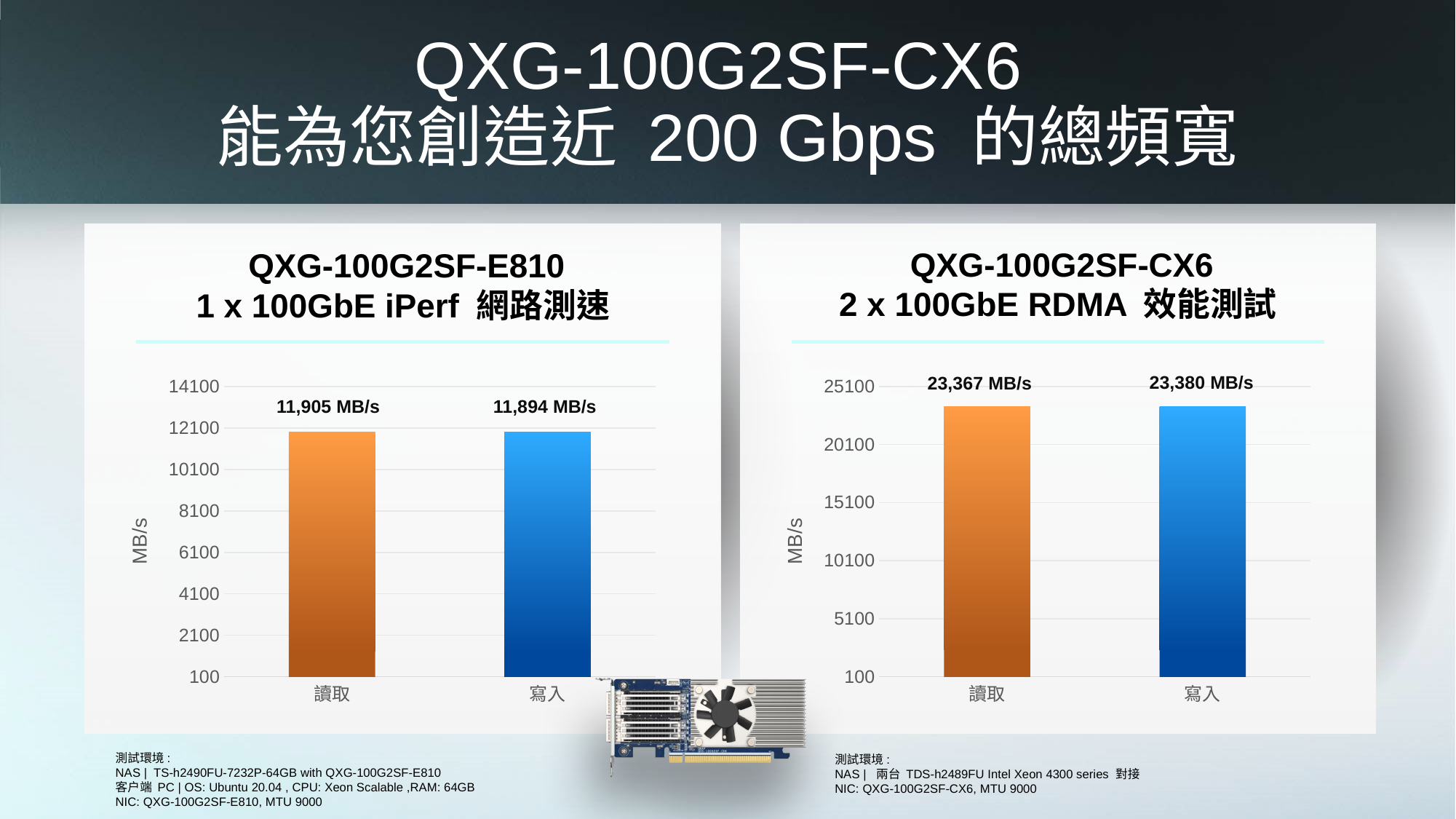
In the right chart (QXG-100G2SF-CX6), based on the data labels, which is larger: 讀取 or 寫入? 寫入 In the left chart (QXG-100G2SF-E810 1 x 100GbE iPerf 網路測速), what is the value for 寫入? 11,894 MB/s What unit is shown on the y axis of the left chart (QXG-100G2SF-E810)? MB/s In the right chart (QXG-100G2SF-CX6 2 x 100GbE RDMA 效能測試), what is the value for 寫入? 23,380 MB/s In the right chart (QXG-100G2SF-CX6 2 x 100GbE RDMA 效能測試), what is the value for 讀取? 23,367 MB/s How many categories are shown in the left chart (QXG-100G2SF-E810)? 2 In the left chart (QXG-100G2SF-E810 1 x 100GbE iPerf 網路測速), what is the value for 讀取? 11,905 MB/s In the left chart (QXG-100G2SF-E810), what is the difference between the 讀取 and 寫入 values? 11 MB/s In the right chart (QXG-100G2SF-CX6), what is the difference between the 寫入 and 讀取 values? 13 MB/s In the left chart (QXG-100G2SF-E810), is the value for 讀取 greater or less than 10100? greater What kind of chart is the right chart (QXG-100G2SF-CX6 2 x 100GbE RDMA 效能測試)? bar chart In the right chart (QXG-100G2SF-CX6), is the value for 寫入 greater or less than 20100? greater